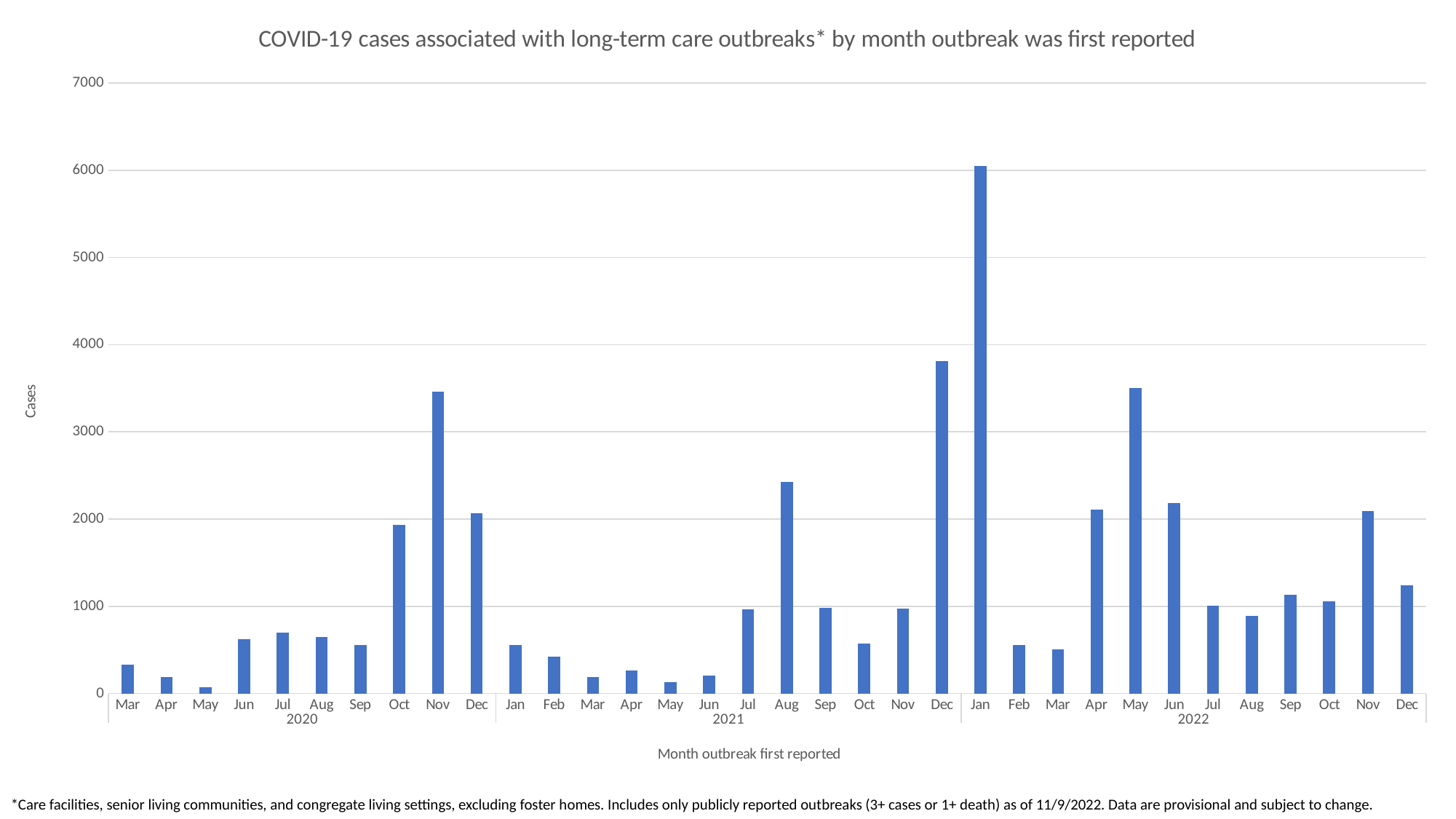
Do the values rise or fall from Jan 2022 to Mar 2022? fall Which has more cases, Aug 2021 or Jun 2022? Aug 2021 Is the value for Nov 2020 greater or less than 3000? greater Which month has the lowest number of cases? May 2020 What kind of chart is shown on the slide? bar chart Is the value for Aug 2021 greater or less than 2000? greater Is the value for Jul 2020 greater or less than 1000? less Which has more cases, Dec 2021 or Nov 2020? Dec 2021 How many monthly bars are plotted in the chart? 34 What is the label of the vertical axis? Cases Which month has the highest number of cases? Jan 2022